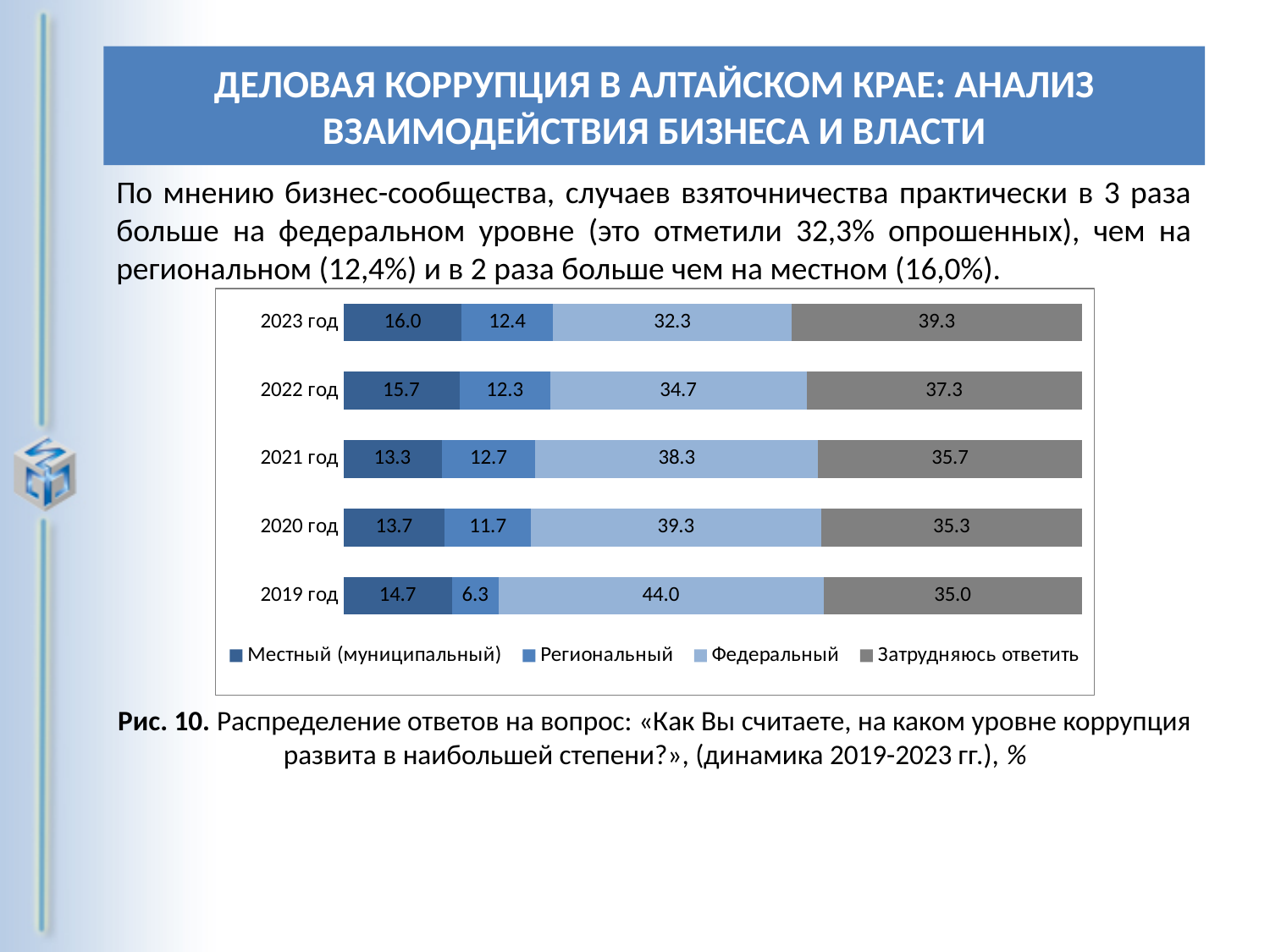
What is the value for Федеральный in 2023 год? 32.3 Does the Федеральный value rise or fall from 2019 год to 2023 год? Fall What is the total of the stacked bar for 2021 год? 100.0 How many years are shown on the chart? 5 In which year is the Региональный value lowest? 2019 год In which year is the Федеральный value highest? 2019 год How many series does the legend list? 4 What kind of chart is shown on the slide? Stacked bar chart Which series is shown in grey? Затрудняюсь ответить What is the difference between the Федеральный values for 2019 год and 2023 год? 11.7 What is the value for Региональный in 2019 год? 6.3 Which is larger, the Затрудняюсь ответить value for 2023 год or for 2022 год? 2023 год